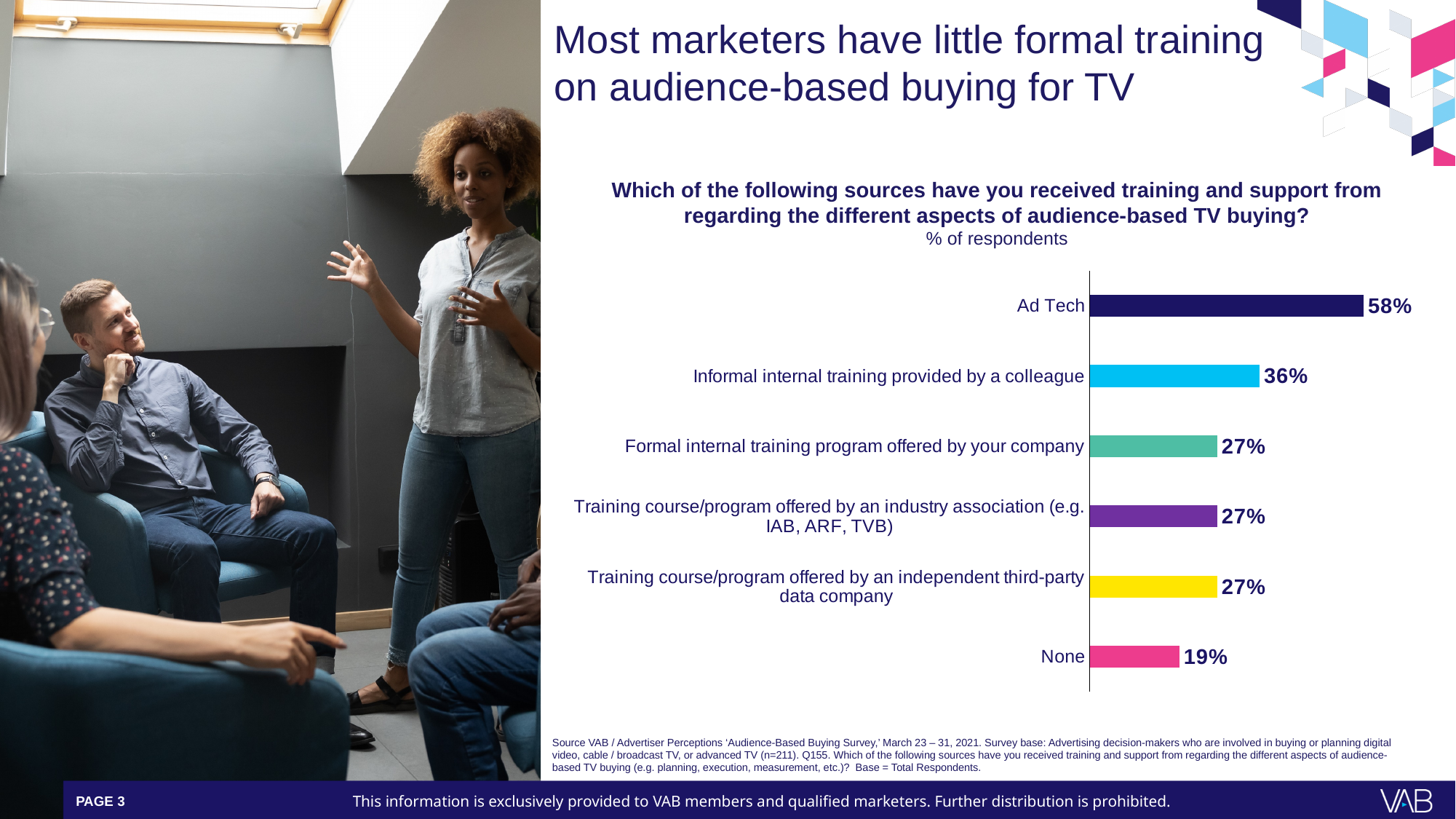
What type of chart is used on this slide? Bar chart What is the difference in percentage points between informal internal training provided by a colleague and 'None'? 17 What percentage of respondents received training and support from Ad Tech? 58% Which is larger: the percentage for Ad Tech or the percentage for informal internal training provided by a colleague? Ad Tech What percentage of respondents selected 'None' as a source of training and support? 19% What percentage of respondents received informal internal training provided by a colleague? 36% What percentage of respondents received a formal internal training program offered by their company? 27% How many categories share the value of 27%? 3 Which category has the lowest percentage of respondents? None What is the difference in percentage points between Ad Tech and informal internal training provided by a colleague? 22 How many categories are shown in the bar chart? 6 Which source of training and support has the highest percentage of respondents? Ad Tech